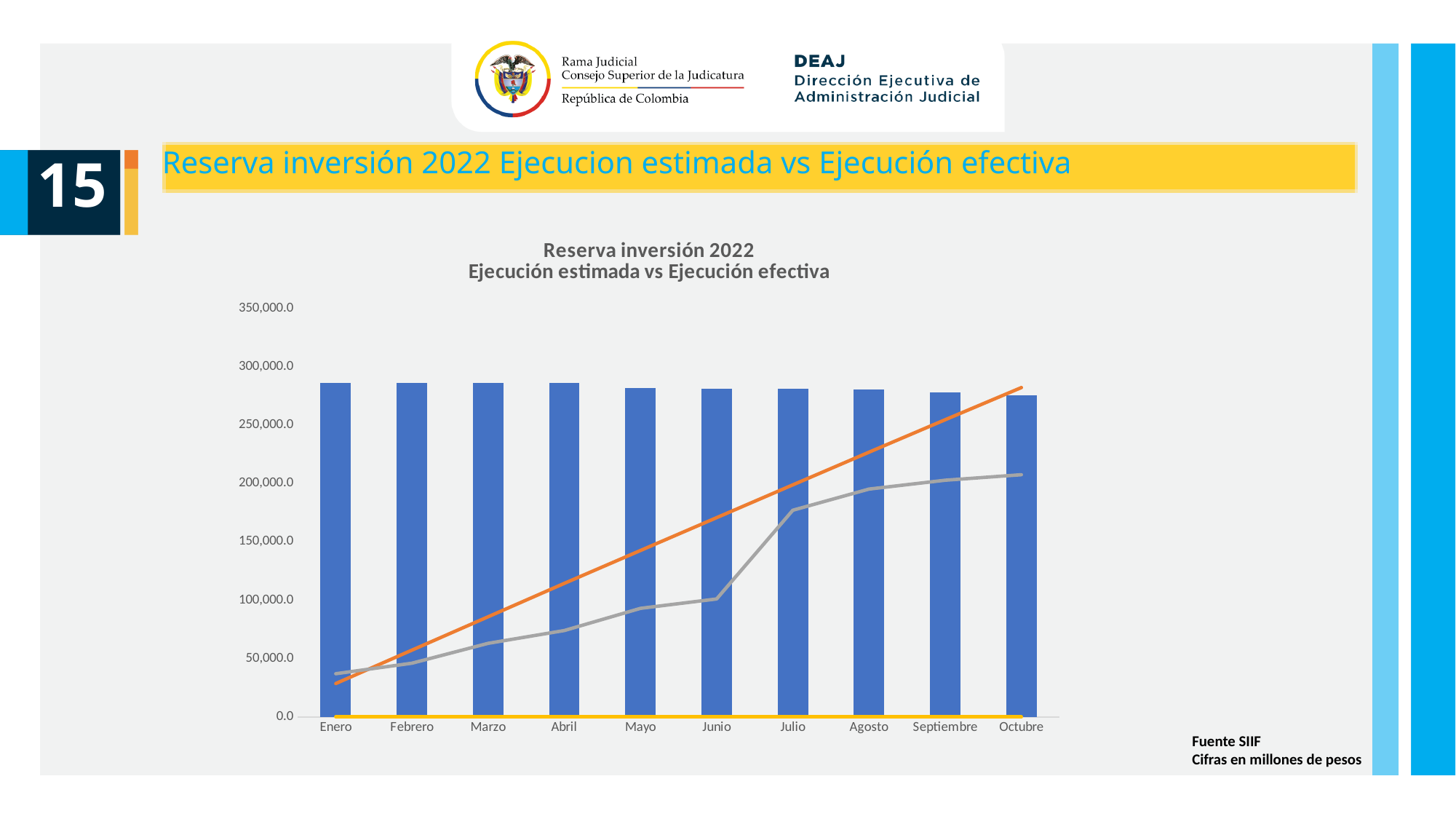
Does the orange line rise or fall from Enero to Octubre? rise Is the blue bar for Enero greater or less than 250,000.0? greater Is the orange line value for Octubre greater or less than 250,000.0? greater Which blue bar is taller, Enero or Octubre? Enero Does the grey line rise or fall from Enero to Octubre? rise Which is the first month shown on the x axis? Enero Is the blue bar for Octubre greater or less than 300,000.0? less What is the title of the chart? Reserva inversión 2022 Ejecución estimada vs Ejecución efectiva How many months are shown on the x axis of the chart? 10 What kind of chart is shown on the slide? A combined bar and line chart